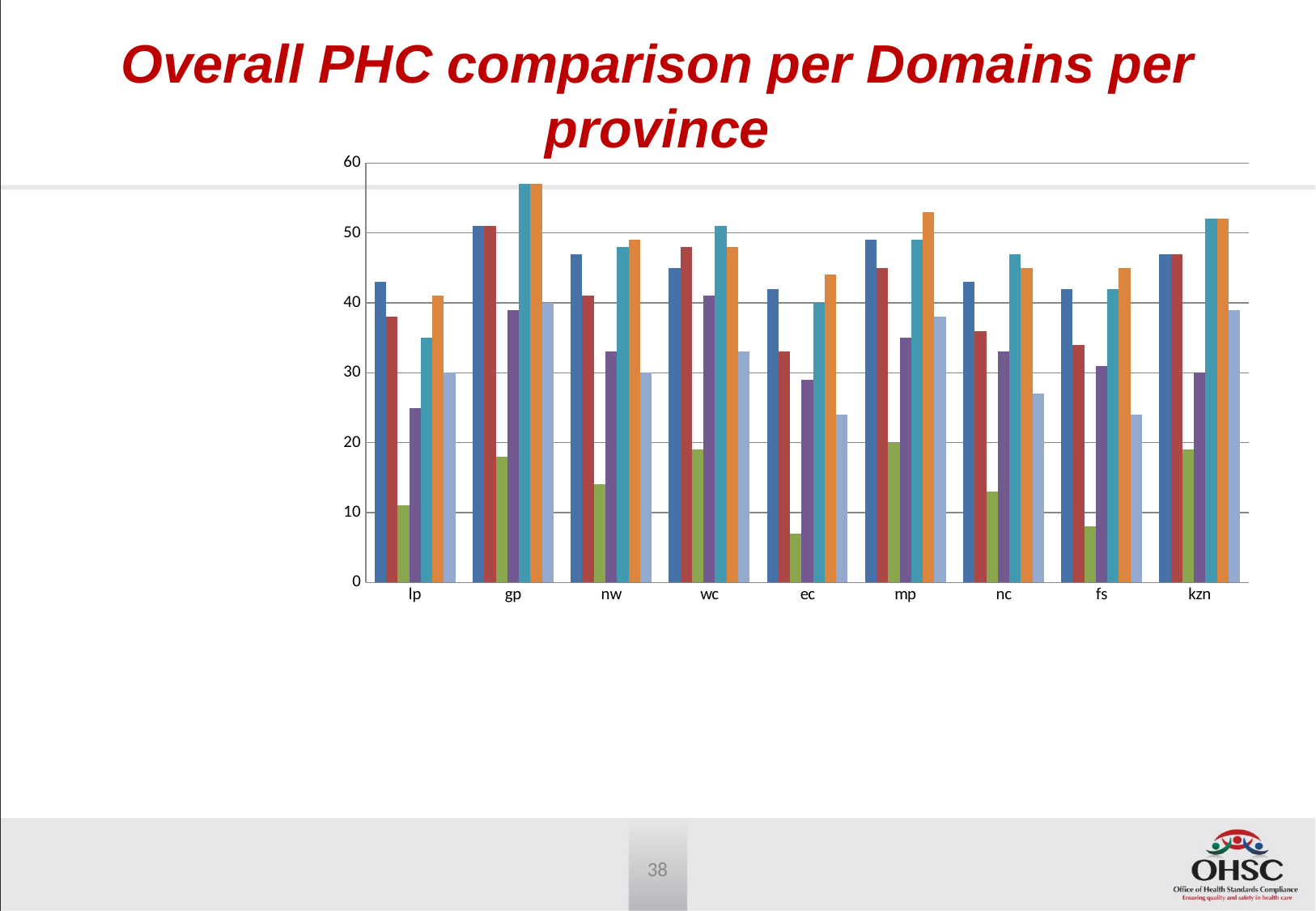
What is the title of the chart on the slide? Overall PHC comparison per Domains per province Is the value of the teal bar for gp greater or less than 50? greater Is the value of the green bar for fs greater or less than 10? less Is the value of the light blue bar for ec greater or less than 20? greater What kind of chart is shown on the slide? bar chart How many provinces are shown along the x axis of the chart? 9